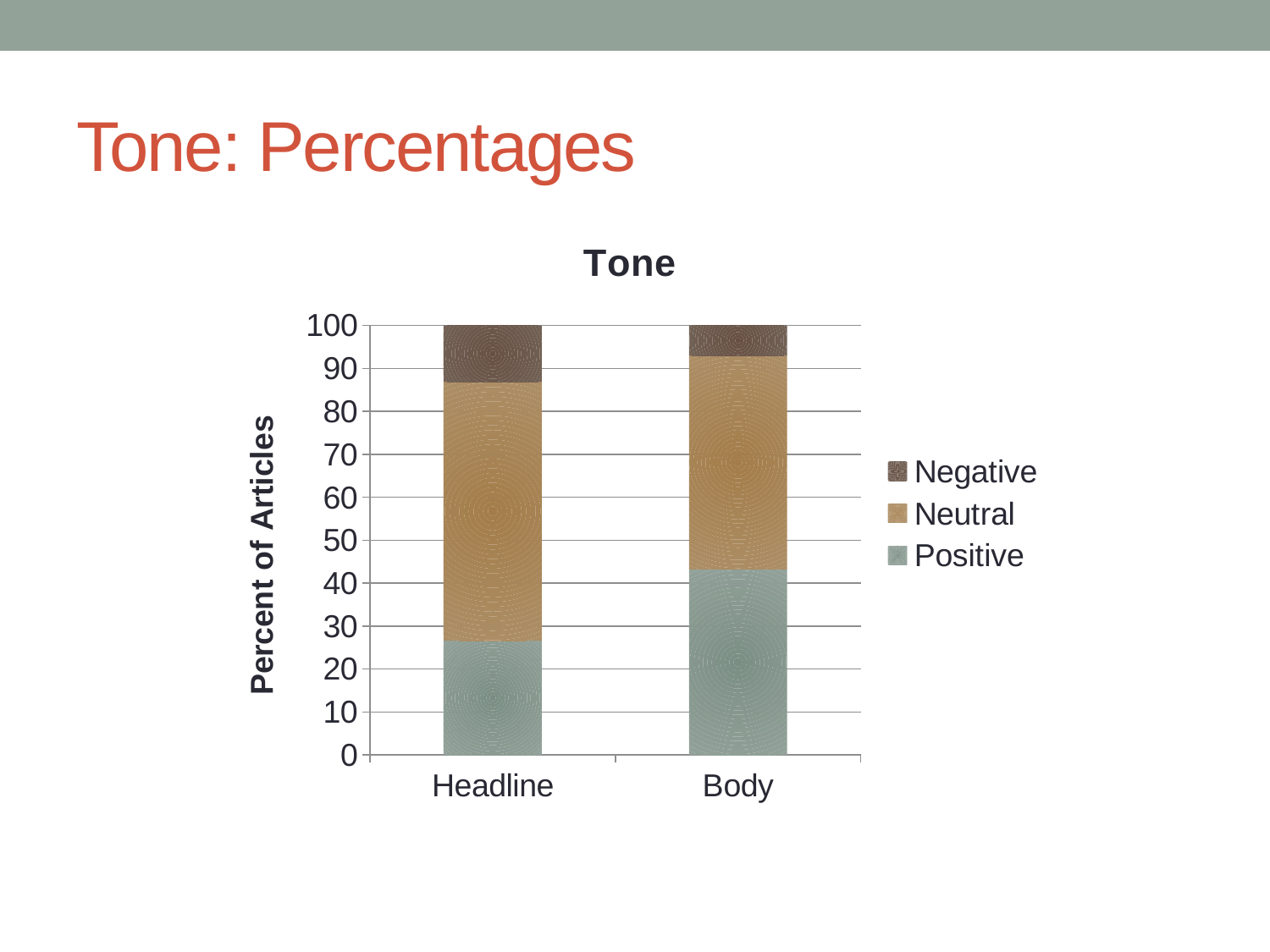
What is the total height of the stacked bar for Headline? 100 Which category has the larger Positive share, Headline or Body? Body Is the Positive value for Body greater or less than 40? greater Which category has the larger Negative share, Headline or Body? Headline How many series does the chart's legend list? 3 Which category has the larger Neutral share, Headline or Body? Headline What is the label on the vertical axis of the chart? Percent of Articles Is the Positive value for Headline greater or less than 30? less What is the title of the chart? Tone How many categories are shown on the x axis of the chart? 2 What kind of chart is shown on the slide? Stacked bar chart Is the Negative value for Body greater or less than 10? less